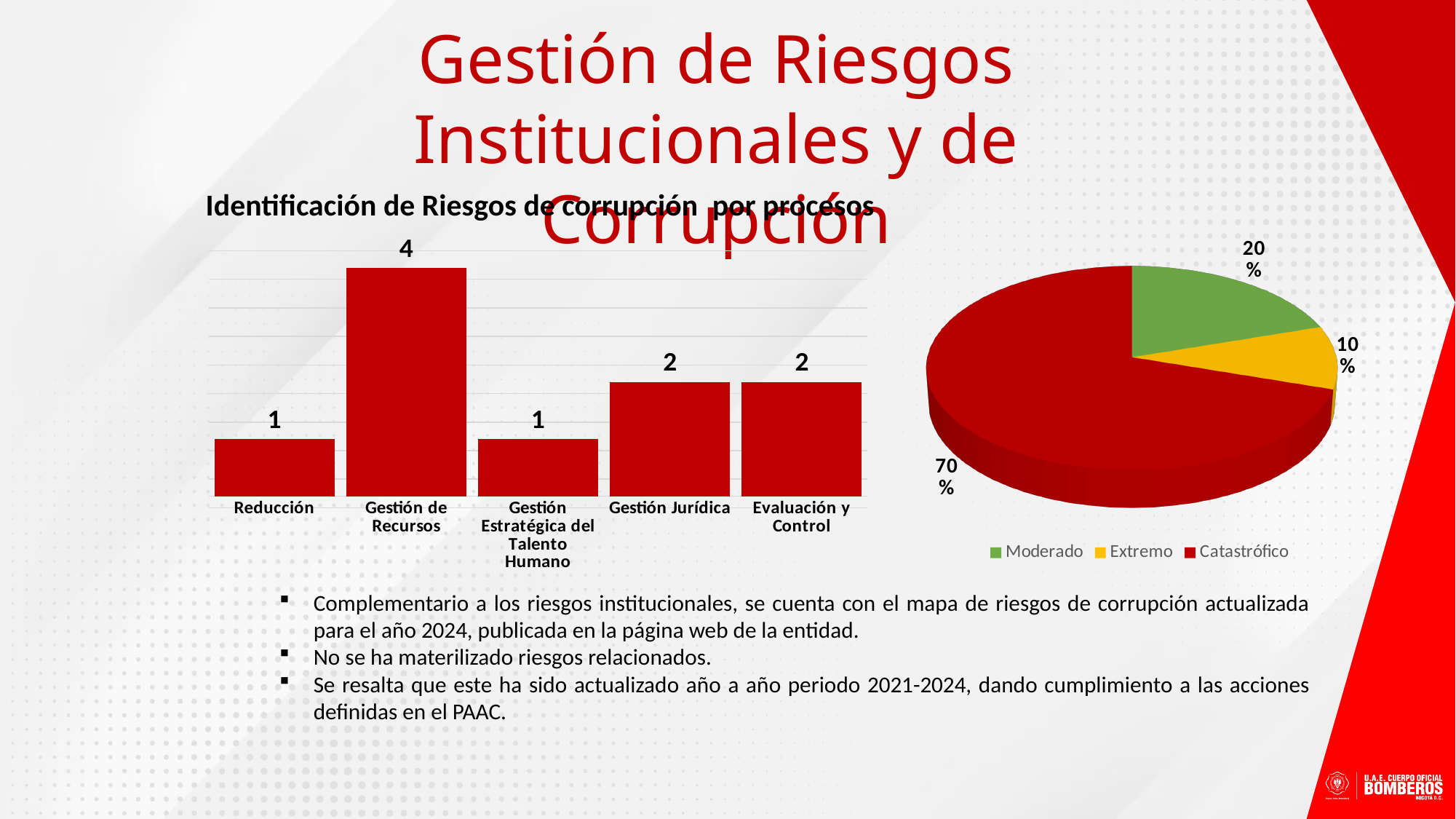
How many series does the legend of the pie chart on the right list? 3 In the pie chart on the right, what share does Extremo have? 10% In the pie chart on the right, what share does Catastrófico have? 70% In the bar chart 'Identificación de Riesgos de corrupción por procesos', what is the value for Gestión Jurídica? 2 In the pie chart on the right, what colour is the Moderado slice? Green What kind of chart is the chart on the left, 'Identificación de Riesgos de corrupción por procesos'? Bar chart In the bar chart 'Identificación de Riesgos de corrupción por procesos', which is larger: Evaluación y Control or Gestión Estratégica del Talento Humano? Evaluación y Control In the bar chart 'Identificación de Riesgos de corrupción por procesos', what is the difference between Gestión de Recursos and Reducción? 3 In the pie chart on the right, which category has the smallest share? Extremo In the bar chart 'Identificación de Riesgos de corrupción por procesos', what is the value for Gestión de Recursos? 4 In the bar chart 'Identificación de Riesgos de corrupción por procesos', how many processes are shown? 5 In the bar chart 'Identificación de Riesgos de corrupción por procesos', which process has the highest value? Gestión de Recursos